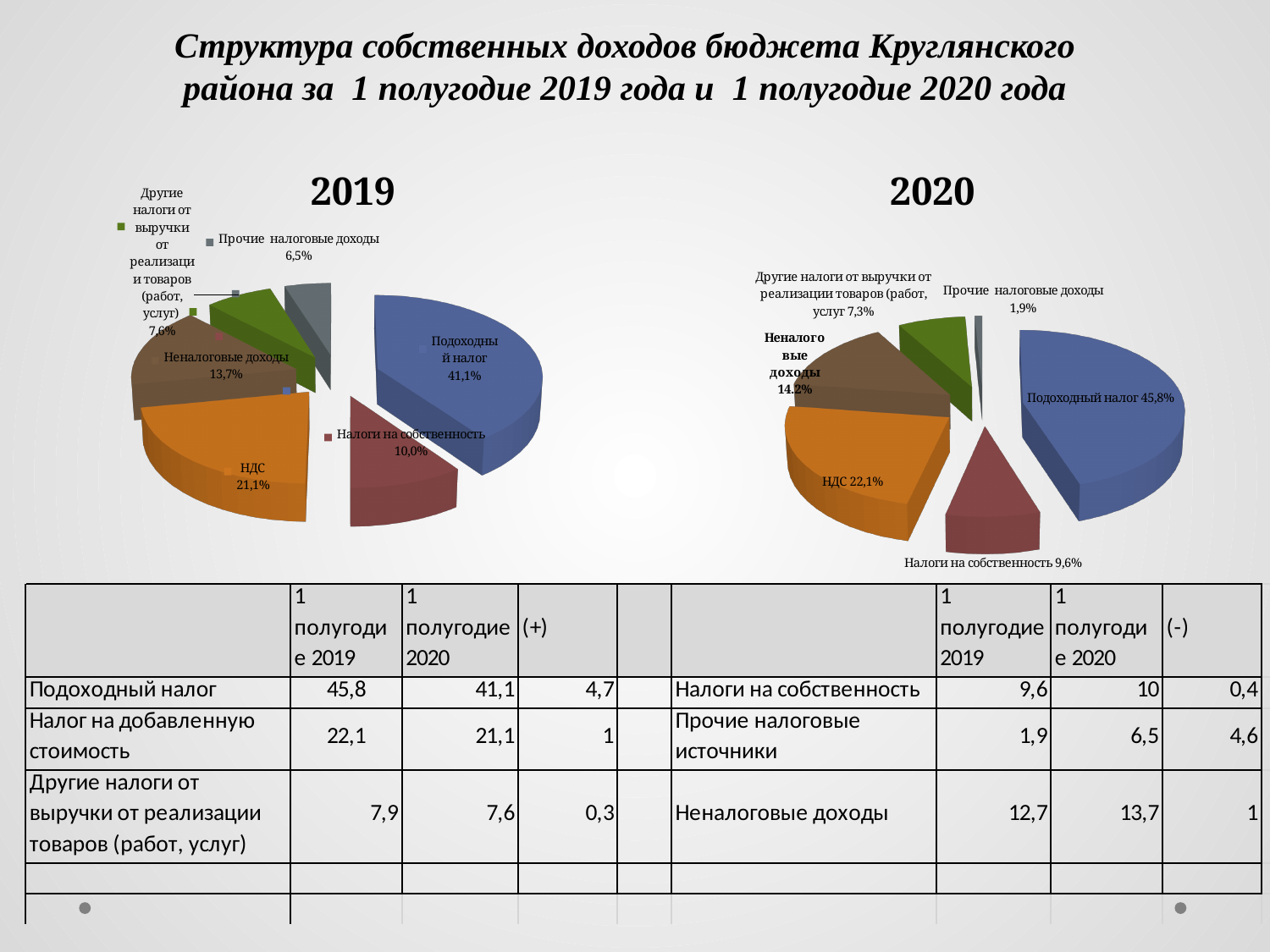
In the 2020 pie chart, which category has the smallest slice? Прочие налоговые доходы In the 2020 pie chart, what share does НДС have? 22,1% How many slices does the 2019 pie chart have? 6 In the 2020 pie chart, what share does Неналоговые доходы have? 14,2% In the 2019 pie chart, what share does Прочие налоговые доходы have? 6,5% In the 2019 pie chart, what colour is the Подоходный налог slice? Blue In the 2019 pie chart, what share does Подоходный налог have? 41,1% In the 2019 pie chart, which category has the smallest slice? Прочие налоговые доходы In the 2020 pie chart, which is larger: Неналоговые доходы or Налоги на собственность? Неналоговые доходы In the 2019 pie chart, what is the difference between the shares of НДС and Налоги на собственность? 11,1% What type of chart is the 2020 chart? Pie chart In the 2020 pie chart, which category has the largest slice? Подоходный налог